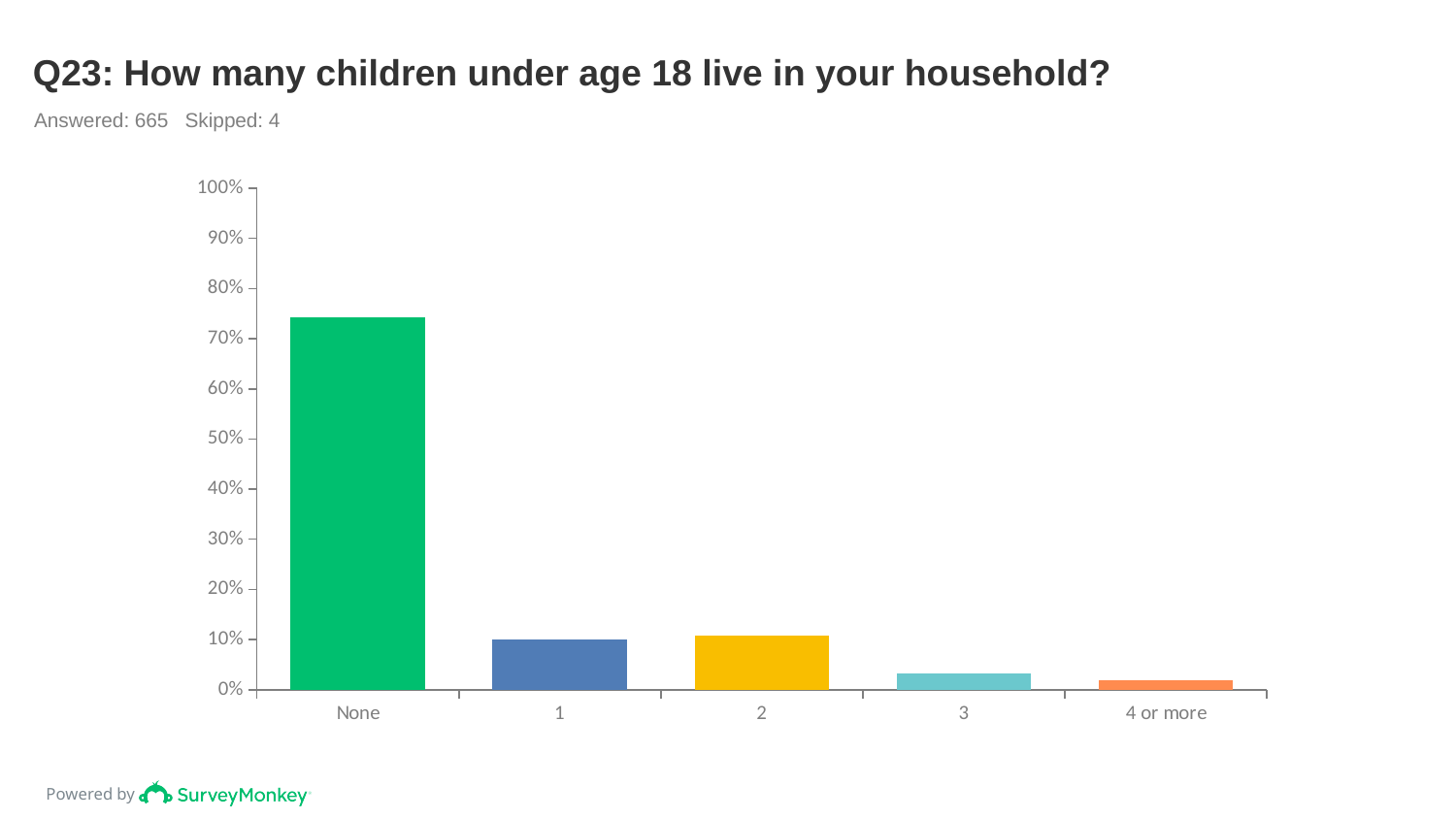
Which is larger, the value for None or the value for 1? None How many categories are shown on the x axis of the chart? 5 Is the value for 1 greater or less than 20%? less Which category has the lowest value in the chart? 4 or more Which is larger, the value for 3 or the value for 4 or more? 3 Is the value for 4 or more greater or less than 10%? less Is the value for None greater or less than 70%? greater Which category has the highest value in the chart? None What kind of chart is shown on the slide? Bar chart How many respondents answered the question shown in the chart title? 665